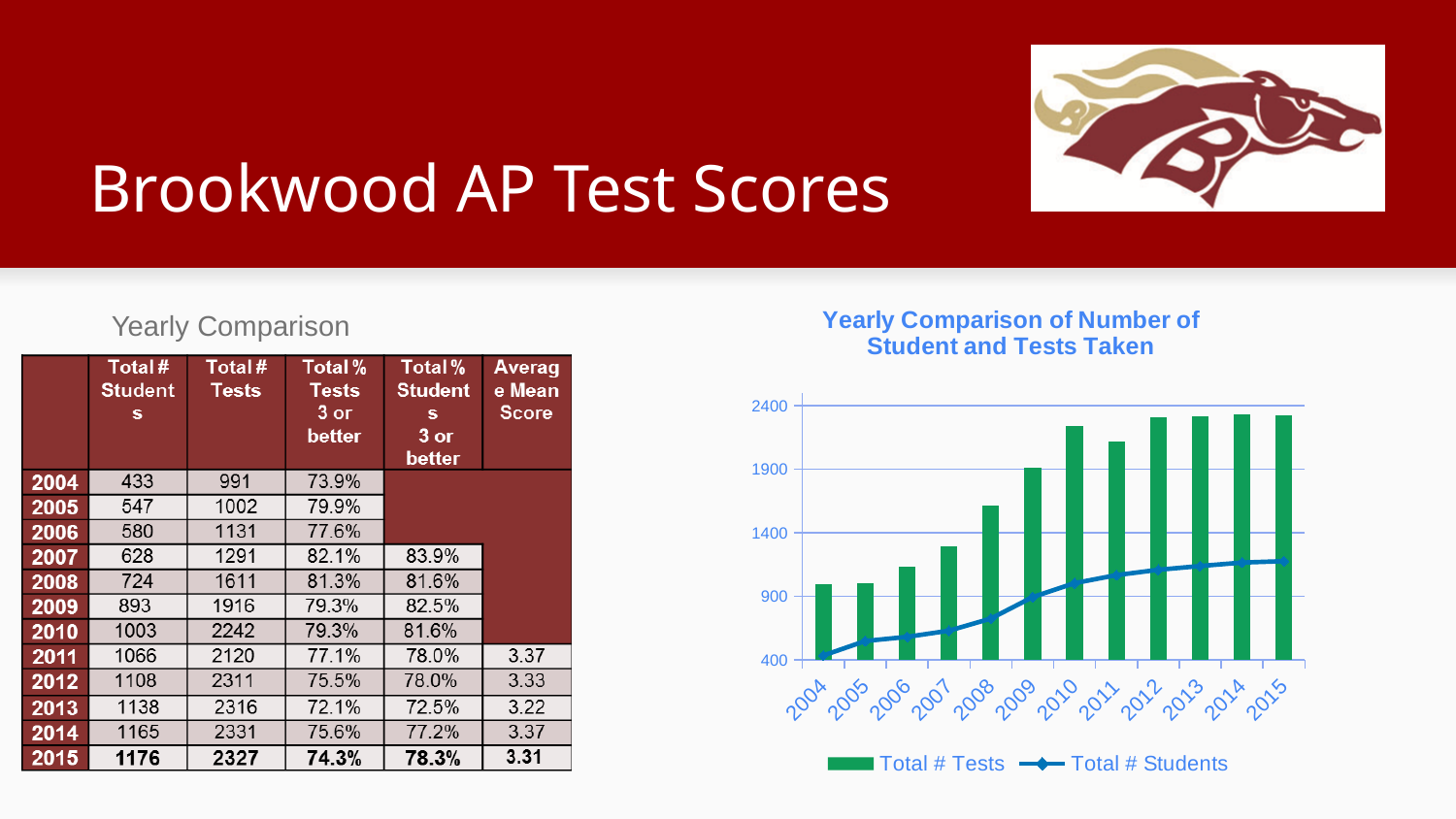
What is the title of the chart on the right side of the slide? Yearly Comparison of Number of Student and Tests Taken In the chart, is the Total # Tests value for 2008 greater or less than 1400? greater Which series in the chart is drawn as a line with markers? Total # Students What kind of chart is used for the Total # Tests series? Bar chart How many series does the legend of the chart list? 2 In the chart, is the Total # Students value for 2015 greater or less than 1400? less In the chart, is the Total # Tests value for 2010 greater or less than 1900? greater In the chart, which year has the lowest Total # Students value? 2004 In the chart, which year has the larger Total # Tests value, 2010 or 2011? 2010 How many years are shown along the x axis of the chart? 12 In the chart, does the Total # Students line generally rise or fall from 2004 to 2015? rise